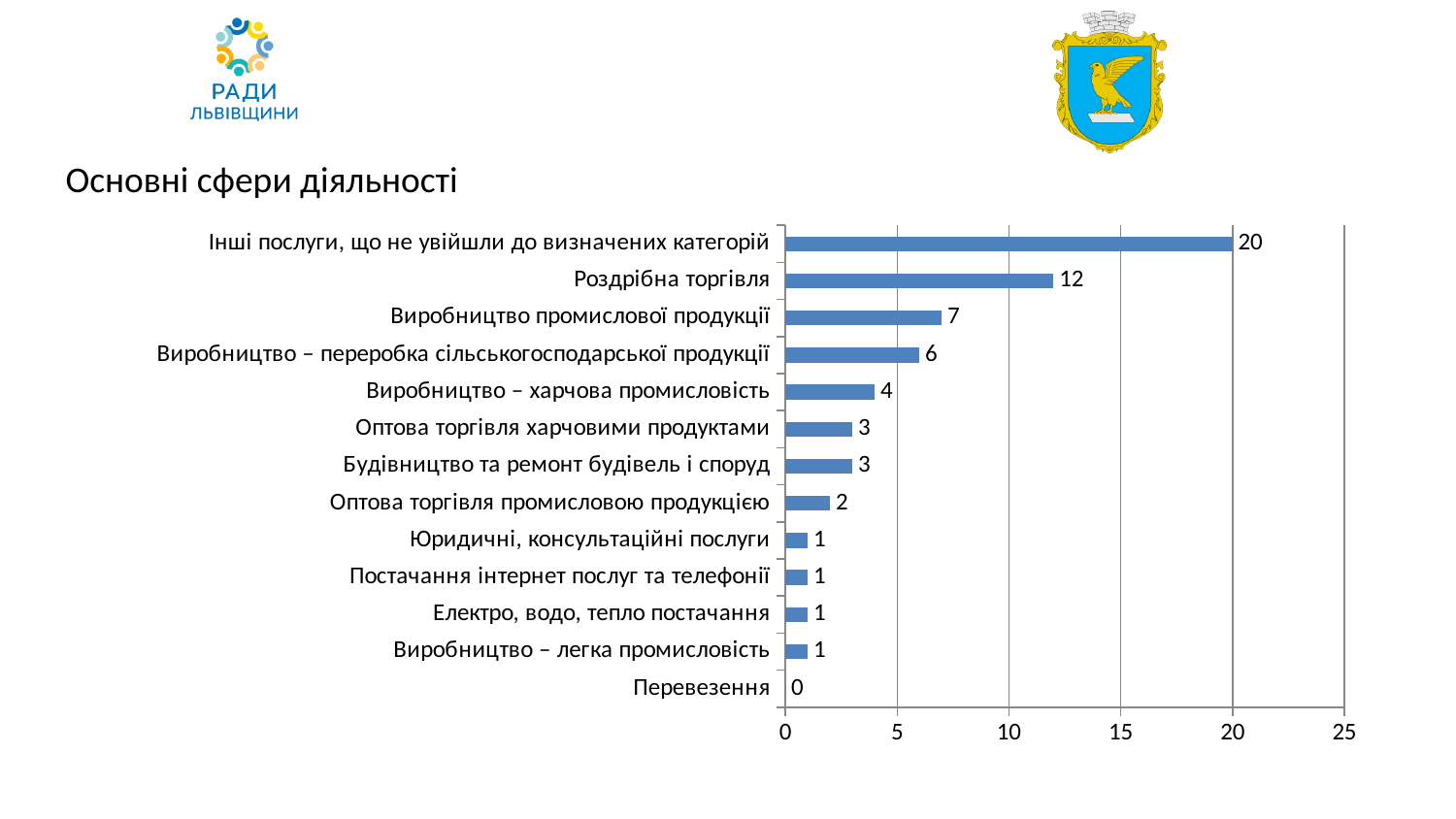
Which is larger: the value for Виробництво промислової продукції or the value for Виробництво – переробка сільськогосподарської продукції? Виробництво промислової продукції What is the value for Оптова торгівля промисловою продукцією? 2 What is the difference between the values for Інші послуги, що не увійшли до визначених категорій and Роздрібна торгівля? 8 What is the title of the slide above the chart? Основні сфери діяльності Which category has the highest value? Інші послуги, що не увійшли до визначених категорій What is the value for Перевезення? 0 What is the value for Виробництво – харчова промисловість? 4 How many categories are shown in the chart? 13 What kind of chart is shown on the slide? bar chart Is the value for Роздрібна торгівля greater or less than 10? greater What is the value for Роздрібна торгівля? 12 Which category has the lowest value? Перевезення